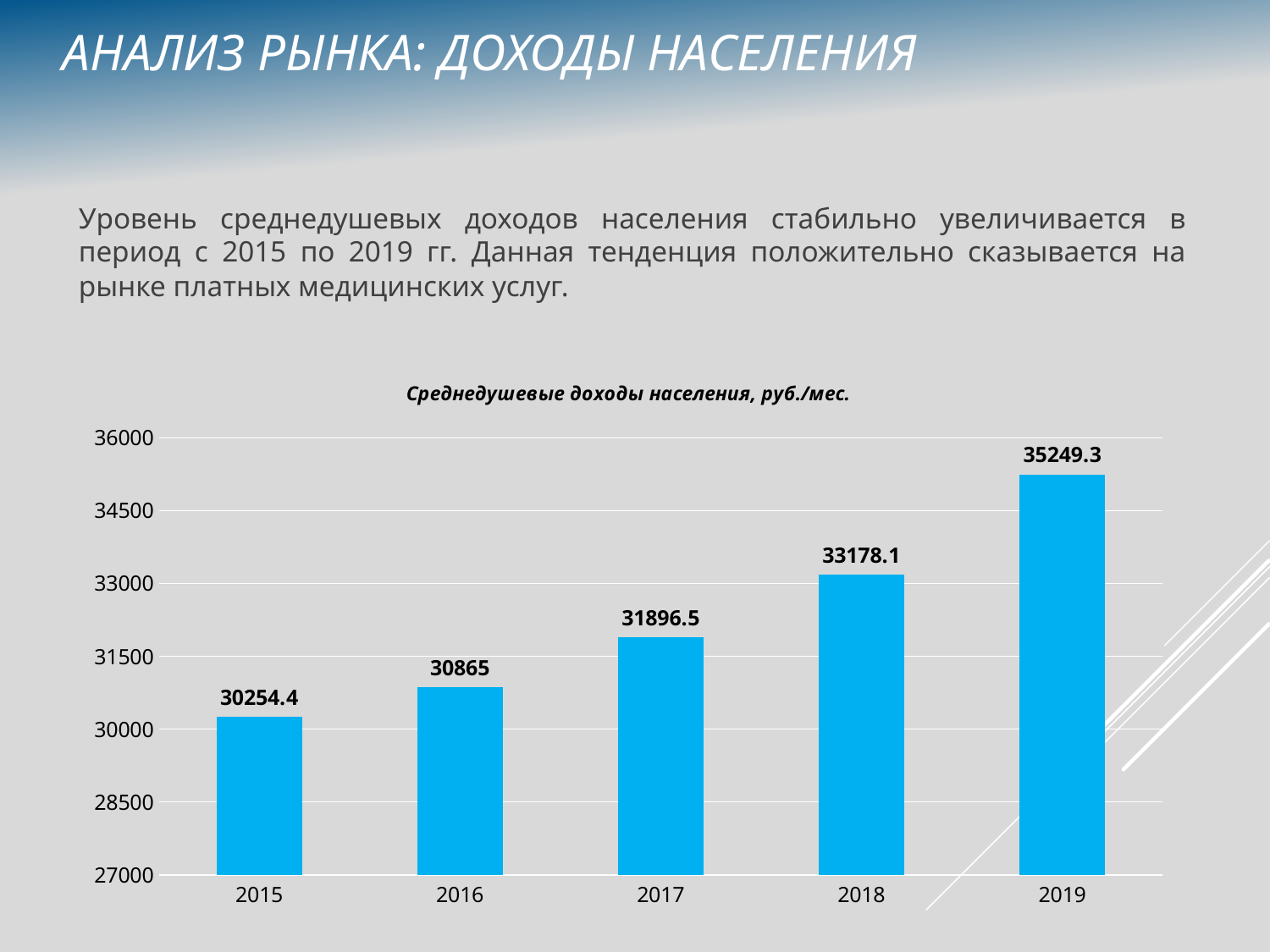
What is the difference between the values for 2019 and 2018? 2071.2 What is the value for 2015? 30254.4 What kind of chart is this? bar chart Which year has the lowest value? 2015 Which is larger, the value for 2017 or the value for 2018? 2018 Do the values rise or fall from 2015 to 2019? rise Is the value for 2018 greater or less than 33000? greater What is the value for 2019? 35249.3 How many years are shown on the x axis? 5 Which year has the highest value? 2019 What is the difference between the values for 2016 and 2015? 610.6 What is the value for 2017? 31896.5